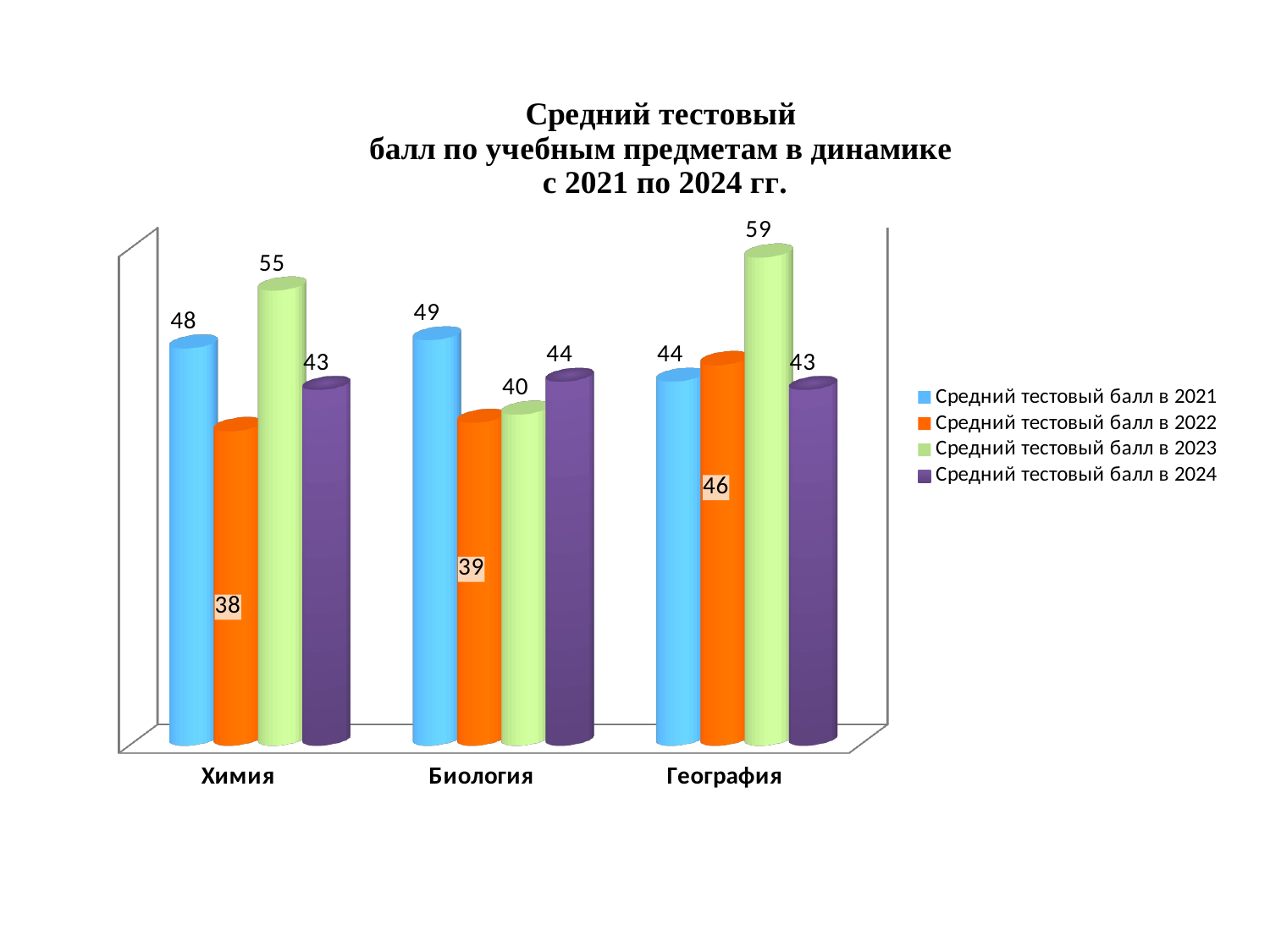
What is the difference between the 2023 and 2022 average test scores for География? 13 How many series does the legend list? 4 What is the average test score in 2024 for География? 43 What is the average test score in 2021 for Биология? 49 How many subjects are shown on the x axis? 3 Which subject has the highest average test score in 2023? География Which subject has the lowest average test score in 2022? Химия What is the average test score in 2023 for Химия? 55 Which colour represents the series 'Средний тестовый балл в 2022' in the legend? Orange What kind of chart is shown on the slide? Bar chart Which is larger for Химия: the average test score in 2021 or in 2024? 2021 What is the average test score in 2022 for Биология? 39